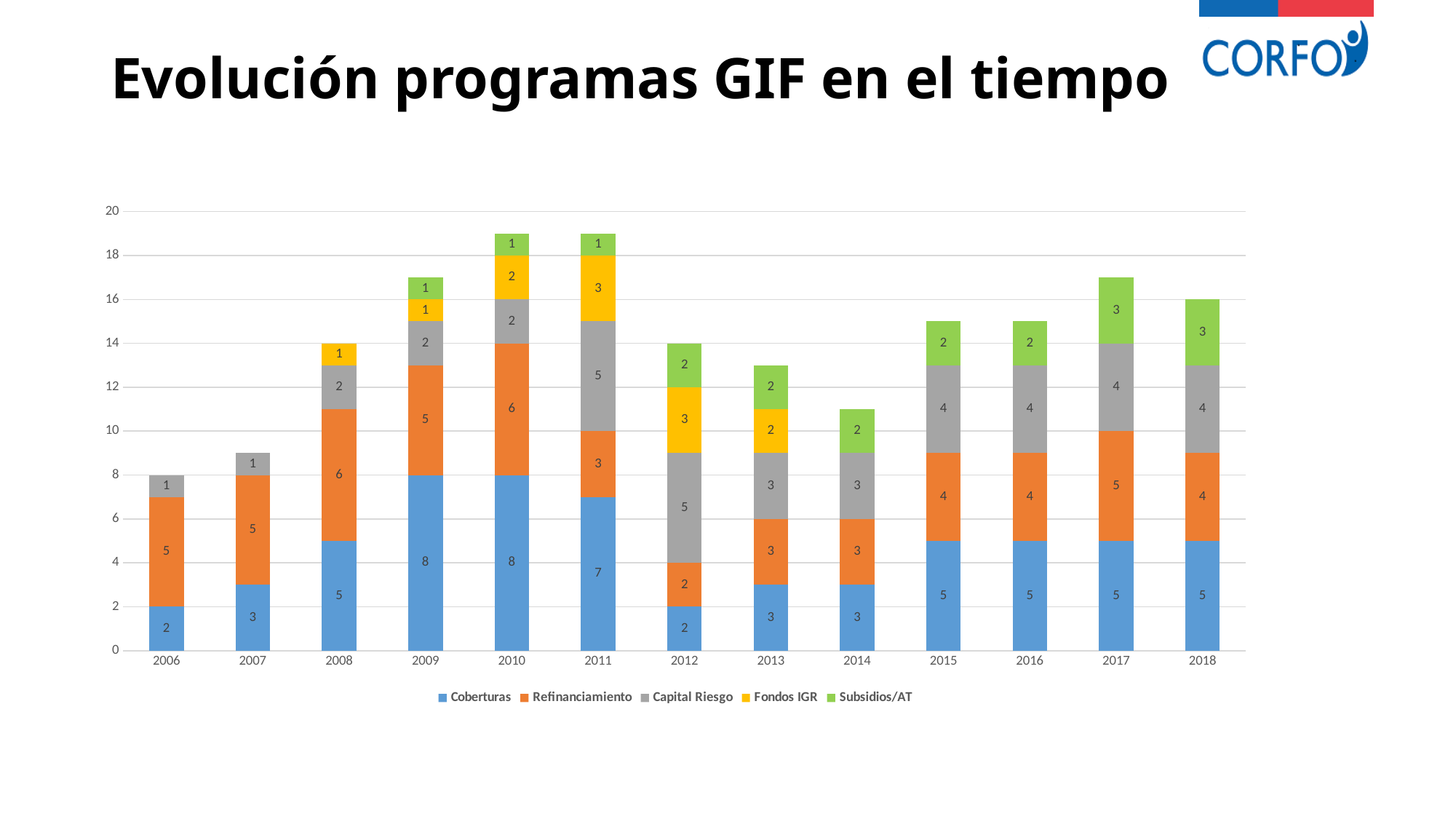
Which year has the lowest total stacked bar? 2006 What is the value for Coberturas in 2010? 8 How many years are shown on the x axis? 13 What is the difference between the Refinanciamiento values for 2008 and 2012? 4 What is the value for Capital Riesgo in 2012? 5 What is the total of the stacked bar for 2010? 19 Which is larger, the Coberturas value for 2009 or the Coberturas value for 2013? 2009 How many series does the legend list? 5 What is the value for Fondos IGR in 2011? 3 What is the total of the stacked bar for 2006? 8 What kind of chart is shown on the slide? Stacked bar chart What is the value for Subsidios/AT in 2017? 3